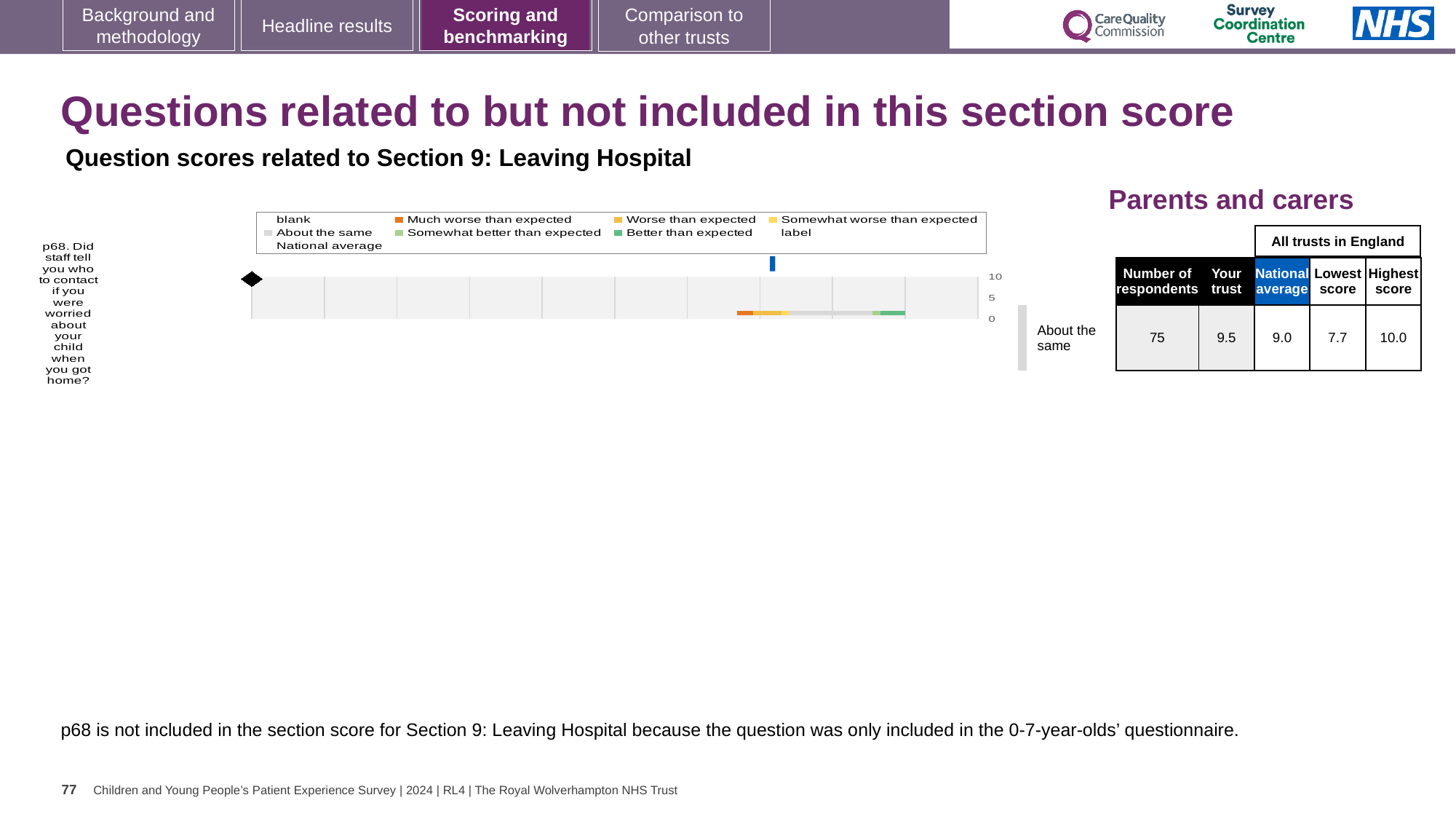
In the table next to the chart, how many respondents answered p68? 75 In the table next to the chart, what is the 'Your trust' score for p68? 9.5 Which question number is plotted in the chart? p68 In the table next to the chart, what is the lowest score among all trusts in England for p68? 7.7 What is the highest value shown on the chart's axis? 10 In the table next to the chart, what is the highest score among all trusts in England for p68? 10.0 How many survey questions are plotted in the chart? 1 Is the national average marker for p68 greater or less than 5? greater In the table next to the chart, what is the national average score for p68? 9.0 Which is larger for p68, the 'Your trust' score or the national average? Your trust What kind of chart is shown on the slide? bar chart What colour does the legend use for 'Much worse than expected'? orange